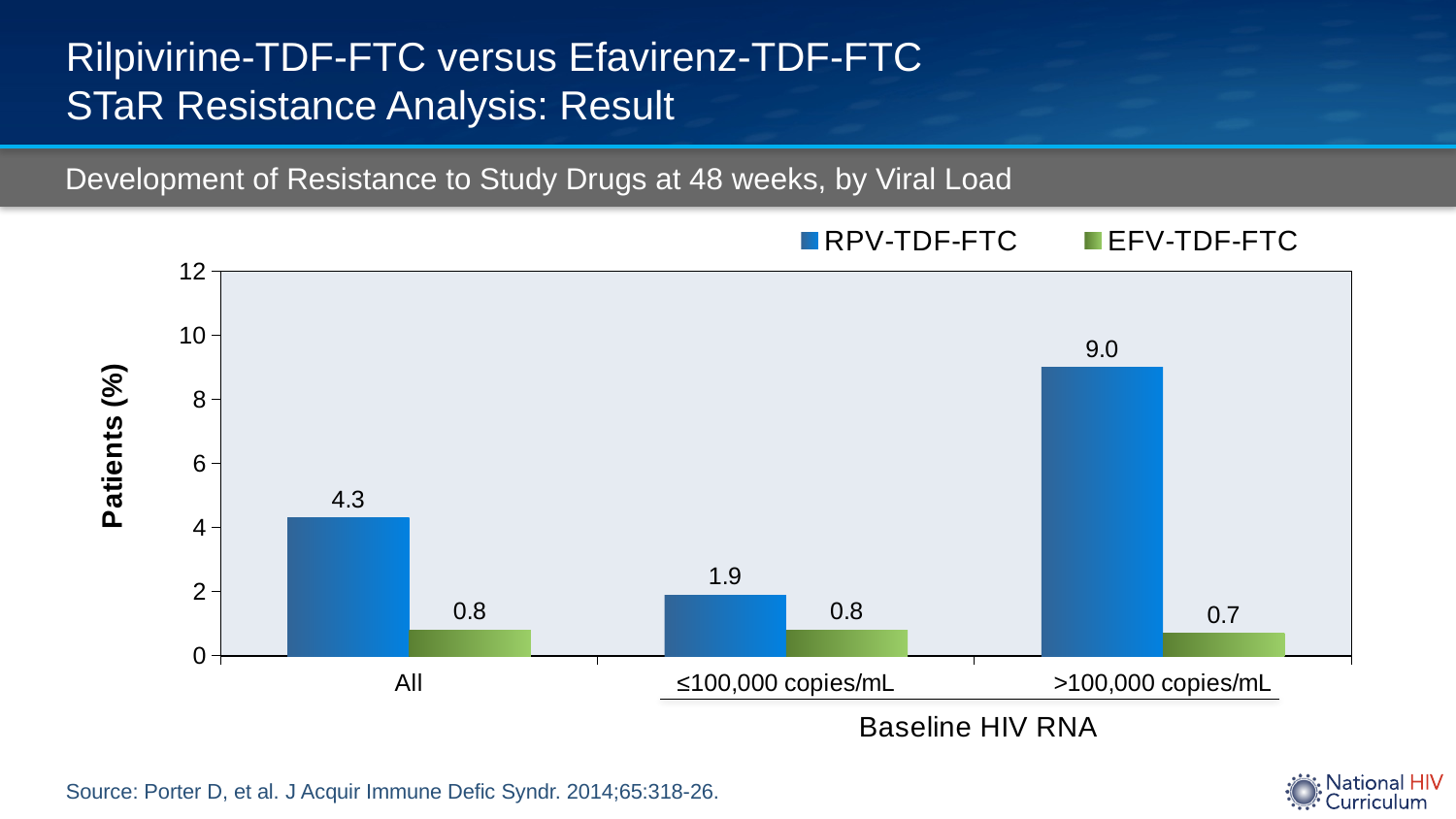
How many series does the legend list? 2 What is the value for EFV-TDF-FTC in the All category? 0.8 In the All category, which series has the larger value, RPV-TDF-FTC or EFV-TDF-FTC? RPV-TDF-FTC Is the RPV-TDF-FTC value for >100,000 copies/mL greater or less than 8? greater What type of chart is shown on the slide? Bar chart What is the value for EFV-TDF-FTC in the >100,000 copies/mL category? 0.7 Which baseline HIV RNA category has the lowest EFV-TDF-FTC value? >100,000 copies/mL What is the value for RPV-TDF-FTC in the ≤100,000 copies/mL category? 1.9 How many baseline HIV RNA categories are shown on the x axis? 3 What is the difference between the RPV-TDF-FTC and EFV-TDF-FTC values in the >100,000 copies/mL category? 8.3 What percentage of patients in the RPV-TDF-FTC group with baseline HIV RNA >100,000 copies/mL developed resistance? 9.0 Which baseline HIV RNA category has the highest RPV-TDF-FTC value? >100,000 copies/mL